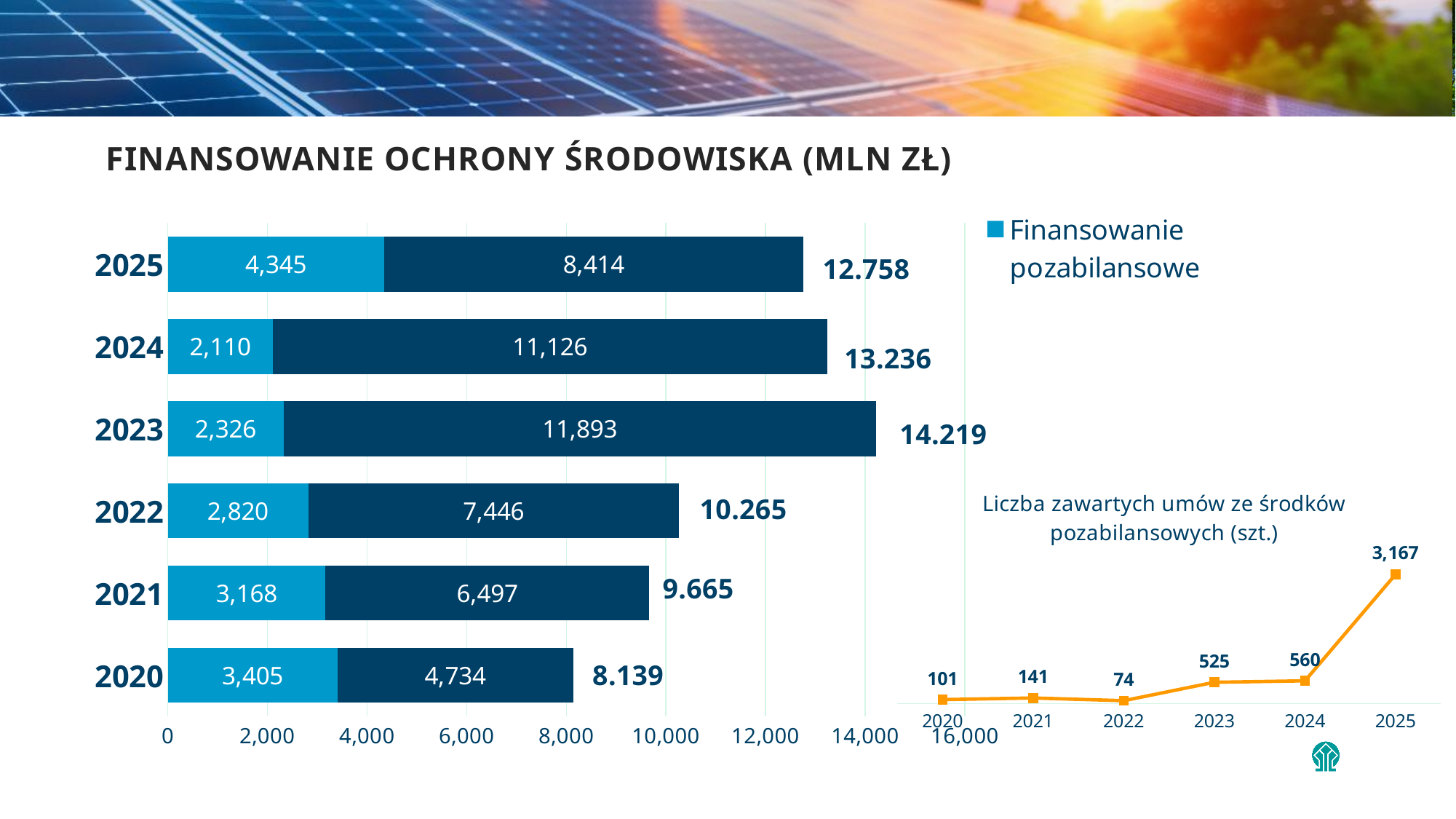
How many years are shown in the bar chart 'Finansowanie ochrony środowiska (mln zł)'? 6 In the bar chart 'Finansowanie ochrony środowiska (mln zł)', which is larger: the 'Finansowanie pozabilansowe' value for 2020 or for 2021? 2020 In the bar chart 'Finansowanie ochrony środowiska (mln zł)', which year has the lowest total? 2020 In the bar chart 'Finansowanie ochrony środowiska (mln zł)', what total is printed at the end of the 2024 bar? 13.236 In the bar chart 'Finansowanie ochrony środowiska (mln zł)', what is the value of the dark blue segment for 2023? 11,893 In the line chart 'Liczba zawartych umów ze środków pozabilansowych (szt.)', which year has the lowest value? 2022 In the bar chart 'Finansowanie ochrony środowiska (mln zł)', which year has the highest total? 2023 In the bar chart 'Finansowanie ochrony środowiska (mln zł)', what is the difference between the dark blue segment values for 2024 and 2022? 3,680 In the line chart 'Liczba zawartych umów ze środków pozabilansowych (szt.)', what is the value for 2025? 3,167 In the line chart 'Liczba zawartych umów ze środków pozabilansowych (szt.)', what is the difference between the values for 2024 and 2023? 35 In the bar chart 'Finansowanie ochrony środowiska (mln zł)', what is the value of the light blue 'Finansowanie pozabilansowe' segment for 2025? 4,345 What type of chart is the chart on the left of the slide? Stacked bar chart